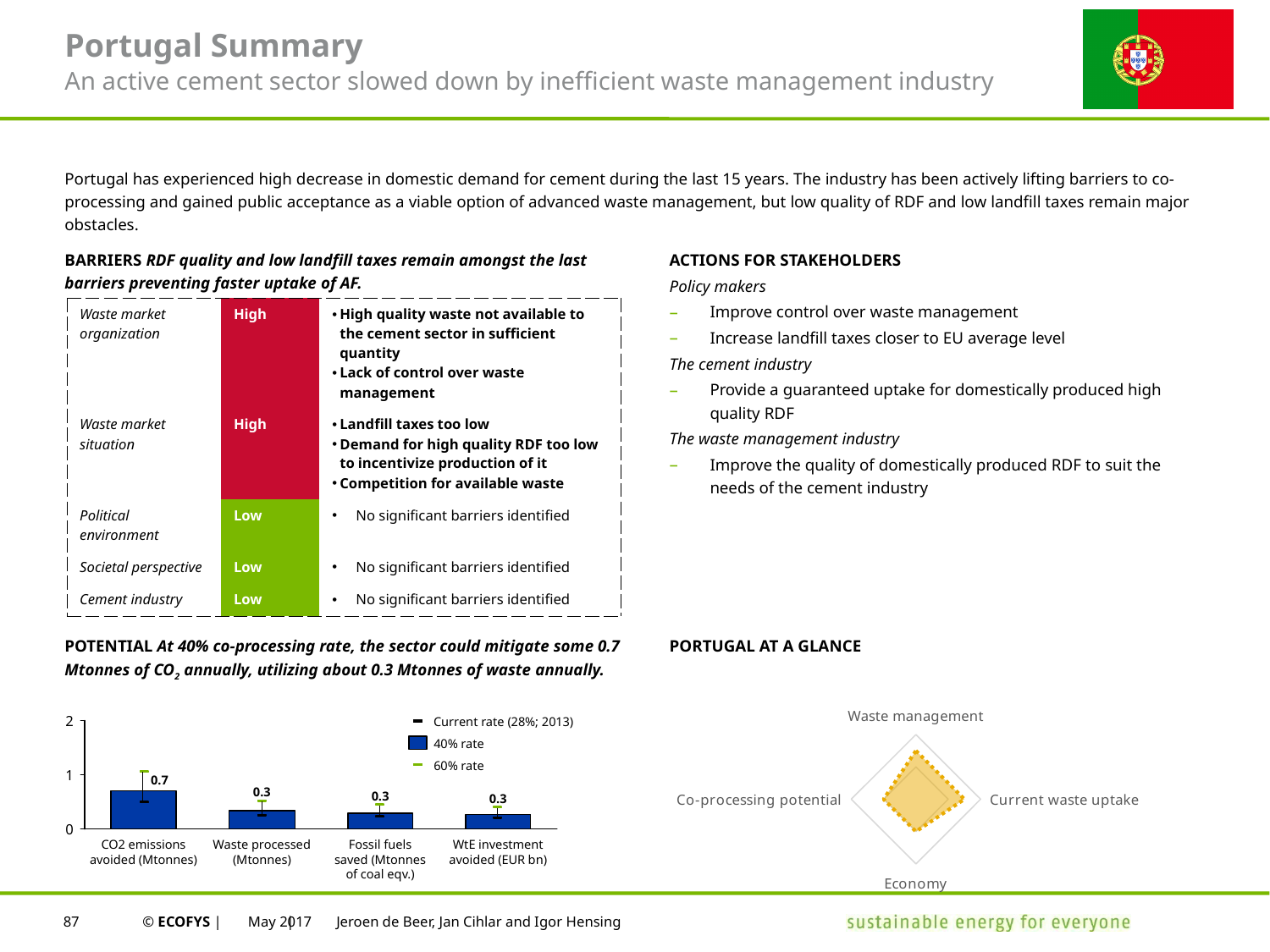
In the bar chart under POTENTIAL, what year is given in the legend entry for the current rate? 2013 How many axes does the radar chart under PORTUGAL AT A GLANCE have? 4 In the bar chart under POTENTIAL, which category has the highest 40% rate bar? CO2 emissions avoided (Mtonnes) What kind of chart is shown under the POTENTIAL heading? Bar chart In the bar chart under POTENTIAL, what is the value of the 40% rate bar for WtE investment avoided (EUR bn)? 0.3 In the bar chart under POTENTIAL, is the 40% rate value for CO2 emissions avoided greater or less than 1? less In the bar chart under POTENTIAL, what is the difference between the 40% rate values for CO2 emissions avoided and Waste processed? 0.4 In the bar chart under POTENTIAL, what is the value of the 40% rate bar for CO2 emissions avoided (Mtonnes)? 0.7 In the bar chart under POTENTIAL, how many categories are shown on the x axis? 4 In the bar chart under POTENTIAL, which is larger at the 40% rate: CO2 emissions avoided or Fossil fuels saved? CO2 emissions avoided In the bar chart under POTENTIAL, what is the value of the 40% rate bar for Waste processed (Mtonnes)? 0.3 In the bar chart under POTENTIAL, how many entries does the legend list? 3